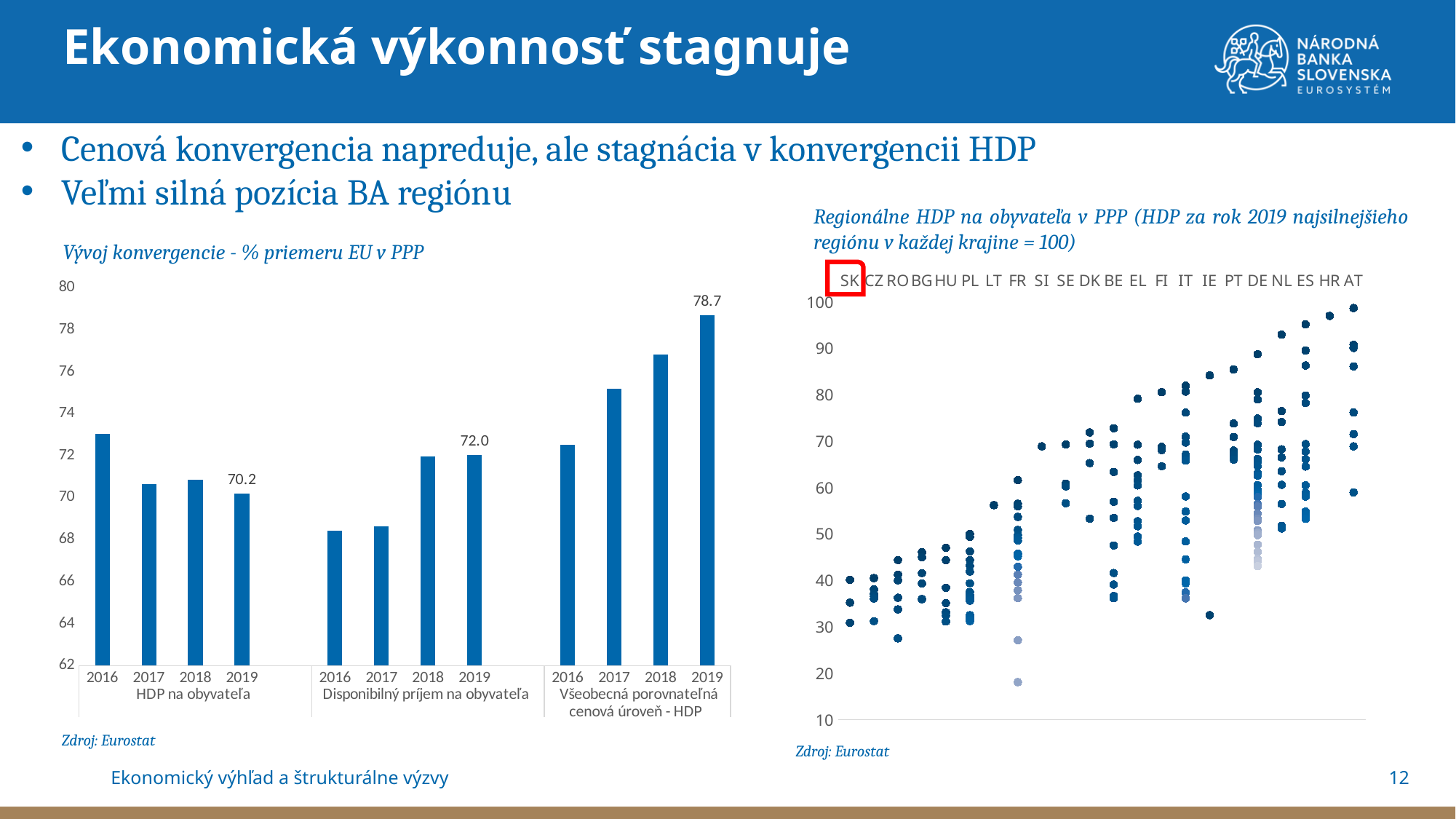
In the left chart 'Vývoj konvergencie - % priemeru EU v PPP', do the values for Všeobecná porovnateľná cenová úroveň - HDP rise or fall from 2016 to 2019? rise In the left chart 'Vývoj konvergencie - % priemeru EU v PPP', which bar is the highest? Všeobecná porovnateľná cenová úroveň - HDP, 2019 In the left chart 'Vývoj konvergencie - % priemeru EU v PPP', is the value for Disponibilný príjem na obyvateľa in 2016 greater or less than 70? less How many countries are shown along the top of the right chart 'Regionálne HDP na obyvateľa v PPP'? 22 In the left chart 'Vývoj konvergencie - % priemeru EU v PPP', what is the value for Disponibilný príjem na obyvateľa in 2019? 72.0 What kind of chart is the left chart 'Vývoj konvergencie - % priemeru EU v PPP'? bar chart In the left chart 'Vývoj konvergencie - % priemeru EU v PPP', which 2019 value is larger: HDP na obyvateľa or Disponibilný príjem na obyvateľa? Disponibilný príjem na obyvateľa In the left chart 'Vývoj konvergencie - % priemeru EU v PPP', what is the difference between the 2019 values for Všeobecná porovnateľná cenová úroveň - HDP and HDP na obyvateľa? 8.5 In the left chart 'Vývoj konvergencie - % priemeru EU v PPP', what is the value for Všeobecná porovnateľná cenová úroveň - HDP in 2019? 78.7 In the right chart 'Regionálne HDP na obyvateľa v PPP', which country label is highlighted with a red box? SK In the left chart 'Vývoj konvergencie - % priemeru EU v PPP', is the value for HDP na obyvateľa in 2016 greater or less than 72? greater In the left chart 'Vývoj konvergencie - % priemeru EU v PPP', what is the value for HDP na obyvateľa in 2019? 70.2